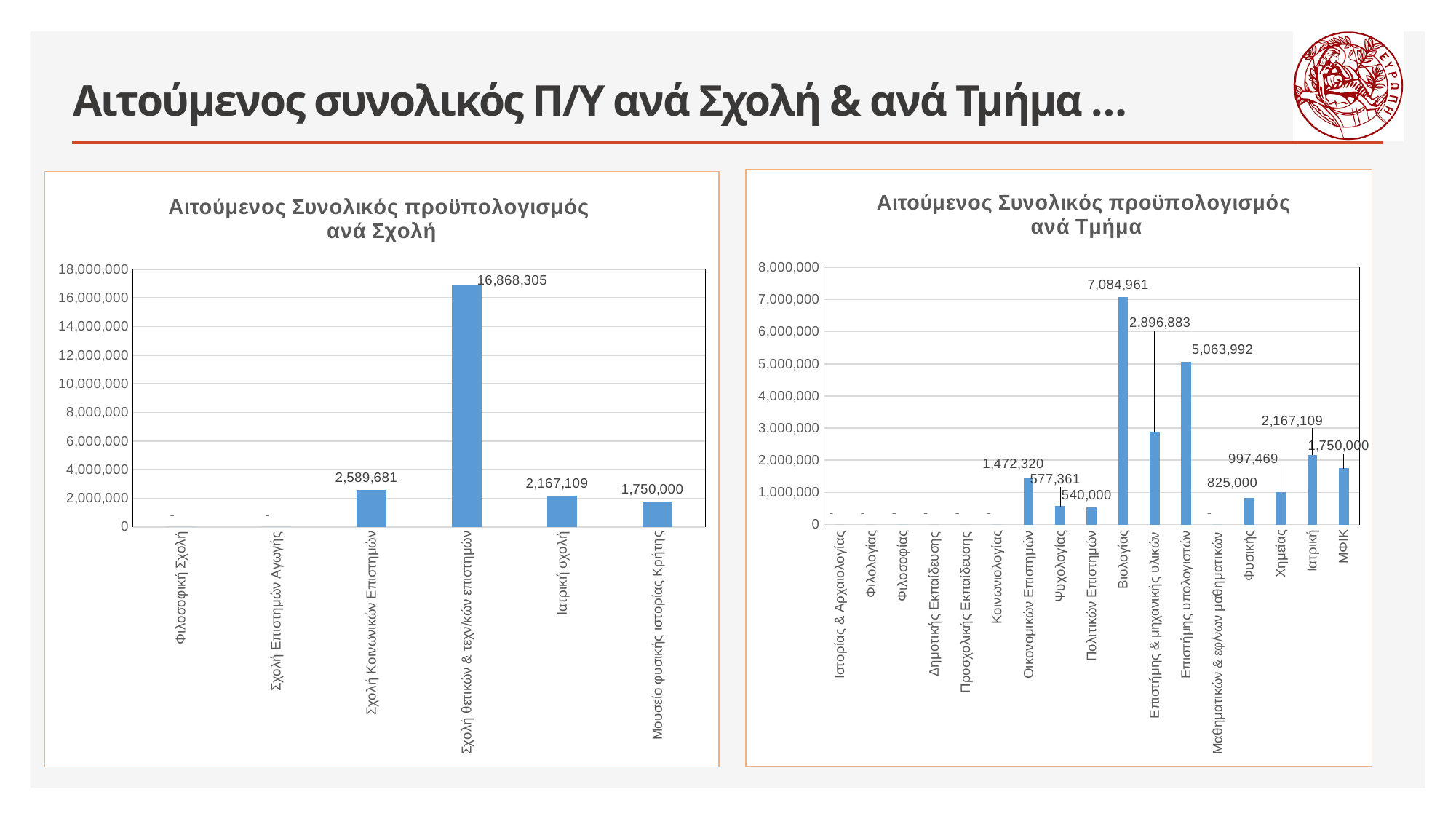
In the right chart (ανά Τμήμα), what is the value for Βιολογίας? 7,084,961 In the right chart (ανά Τμήμα), what is the difference between Βιολογίας and Επιστήμης υπολογιστών? 2,020,969 In the right chart (ανά Τμήμα), what is the value for Επιστήμης υπολογιστών? 5,063,992 In the left chart (ανά Σχολή), what is the value for Σχολή Κοινωνικών Επιστημών? 2,589,681 In the left chart (ανά Σχολή), how many categories are shown on the x axis? 6 In the right chart (ανά Τμήμα), how many departments are listed on the x axis? 17 What type of chart is the left chart (ανά Σχολή)? Bar chart In the right chart (ανά Τμήμα), which is larger, Ψυχολογίας or Πολιτικών Επιστημών? Ψυχολογίας In the left chart (ανά Σχολή), what is the value for Σχολή Θετικών & τεχν/κών επιστημών? 16,868,305 In the right chart (ανά Τμήμα), which department has the highest requested budget? Βιολογίας In the left chart (ανά Σχολή), which school has the highest requested budget? Σχολή Θετικών & τεχν/κών επιστημών In the left chart (ανά Σχολή), what is the difference between Σχολή Θετικών & τεχν/κών επιστημών and Σχολή Κοινωνικών Επιστημών? 14,278,624